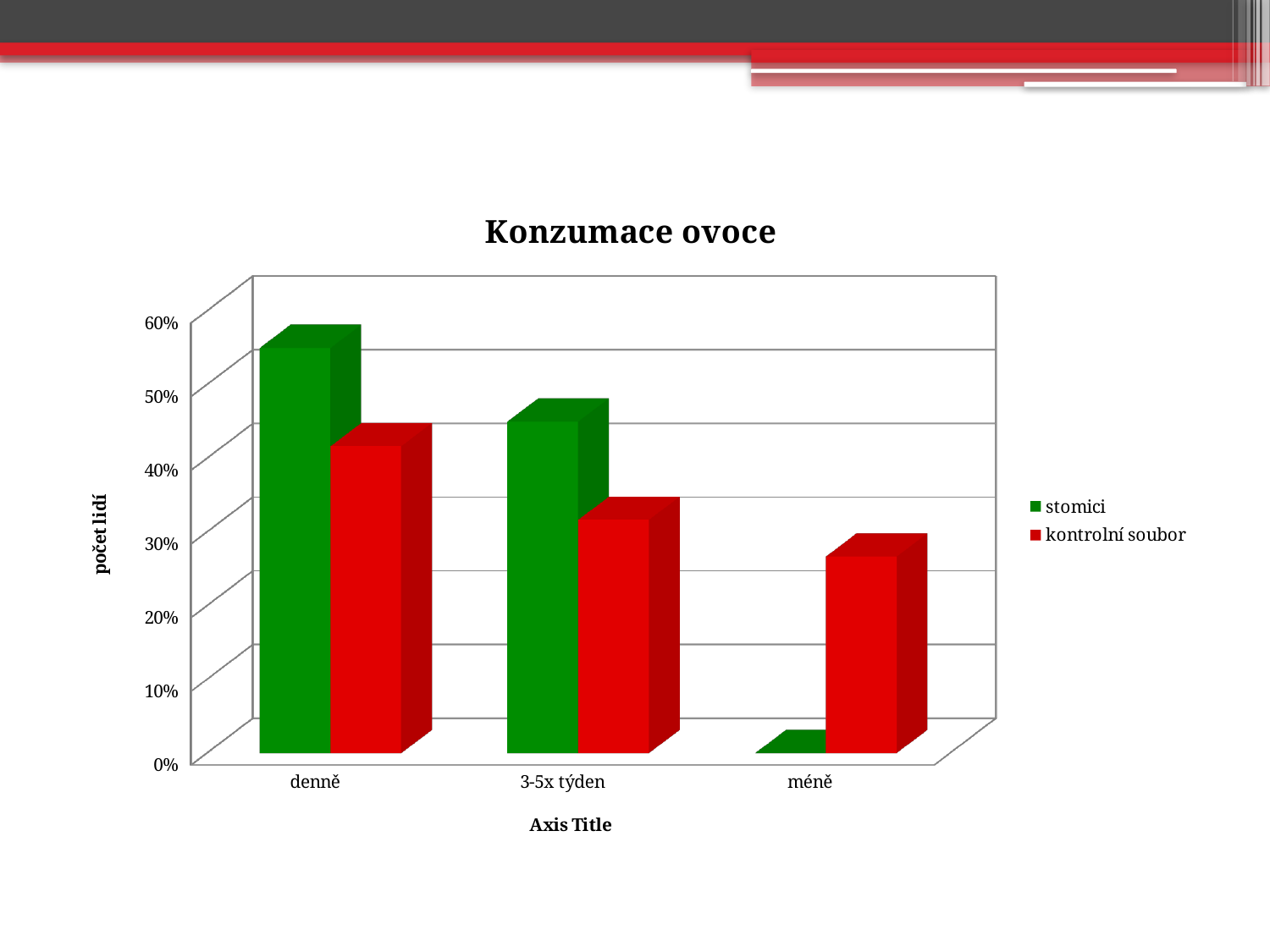
Do the values for the stomici series rise or fall from denně to méně along the x axis? fall How many categories are shown on the x axis? 3 In the méně category, which series has the larger value, stomici or kontrolní soubor? kontrolní soubor How many series does the legend list? 2 Which category has the highest value for the stomici series? denně Is the value for stomici in the denně category greater or less than 50%? greater Is the value for stomici in the méně category greater or less than 10%? less Which category has the lowest value for the kontrolní soubor series? méně In the denně category, which series has the larger value, stomici or kontrolní soubor? stomici What type of chart is shown on the slide? bar chart What is the title of the chart? Konzumace ovoce Is the value for kontrolní soubor in the 3-5x týden category greater or less than 40%? less